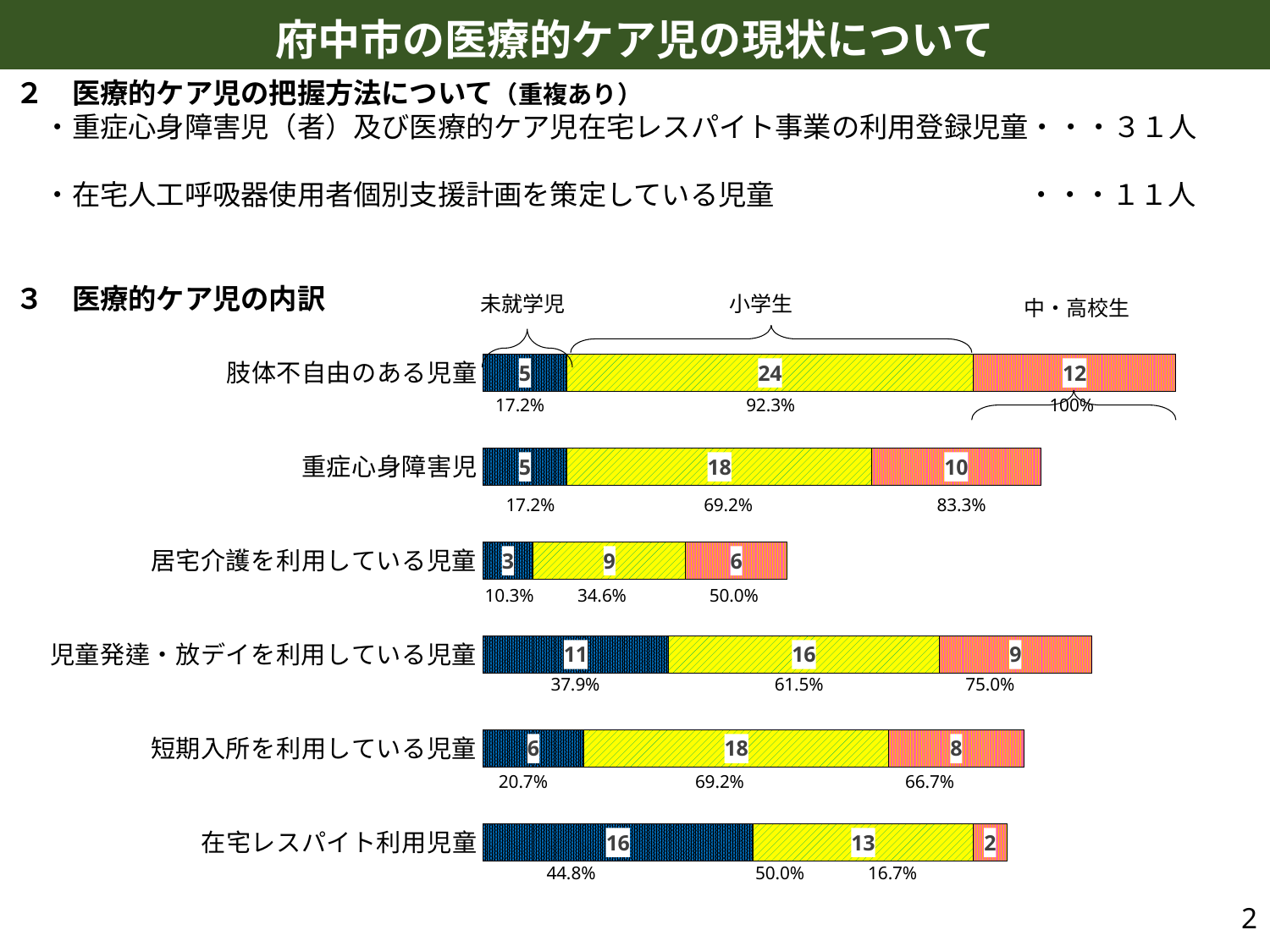
How many series (age groups) does the 医療的ケア児の内訳 chart show? 3 In the 医療的ケア児の内訳 chart, which category has the smallest total bar? 居宅介護を利用している児童 In the 医療的ケア児の内訳 chart, what is the total of the stacked bar for 居宅介護を利用している児童? 18 In the 医療的ケア児の内訳 chart, which is larger: the 未就学児 value for 在宅レスパイト利用児童 or the 未就学児 value for 児童発達・放デイを利用している児童? 在宅レスパイト利用児童 In the 医療的ケア児の内訳 chart, what is the 小学生 value for 肢体不自由のある児童? 24 In the 医療的ケア児の内訳 chart, what is the difference between the 小学生 values for 肢体不自由のある児童 and 短期入所を利用している児童? 6 What type of chart is shown in section 3 (医療的ケア児の内訳)? Stacked bar chart In the 医療的ケア児の内訳 chart, what is the total of the stacked bar for 肢体不自由のある児童? 41 In the 医療的ケア児の内訳 chart, what is the 中・高校生 value for 重症心身障害児? 10 In the 医療的ケア児の内訳 chart, what is the 未就学児 value for 在宅レスパイト利用児童? 16 How many categories (rows) are plotted in the 医療的ケア児の内訳 chart? 6 In the 医療的ケア児の内訳 chart, what percentage is shown under the 中・高校生 segment for 児童発達・放デイを利用している児童? 75.0%